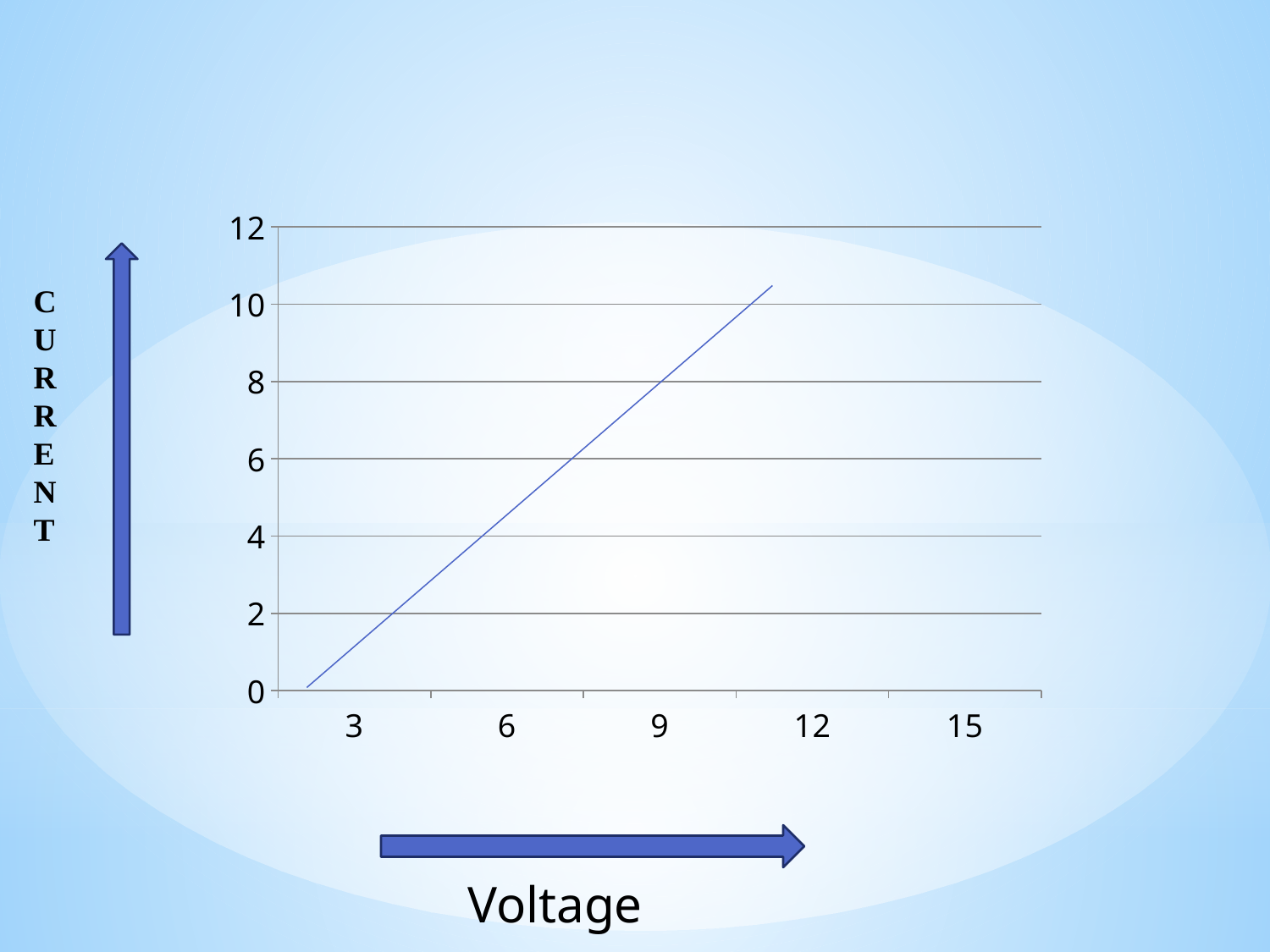
Is the current at a voltage of 9 larger or smaller than the current at a voltage of 3? larger Does the plotted line rise or fall as voltage increases along the x axis? rise Is the current value at a voltage of 6 greater or less than 6? less Is the current value at a voltage of 3 greater or less than 2? less Is the current value at a voltage of 9 greater or less than 6? greater How many tick labels are shown on the x axis? 5 What quantity is labelled along the horizontal axis of the chart? Voltage What kind of chart is shown on the slide? line chart What is the highest value labelled on the y axis? 12